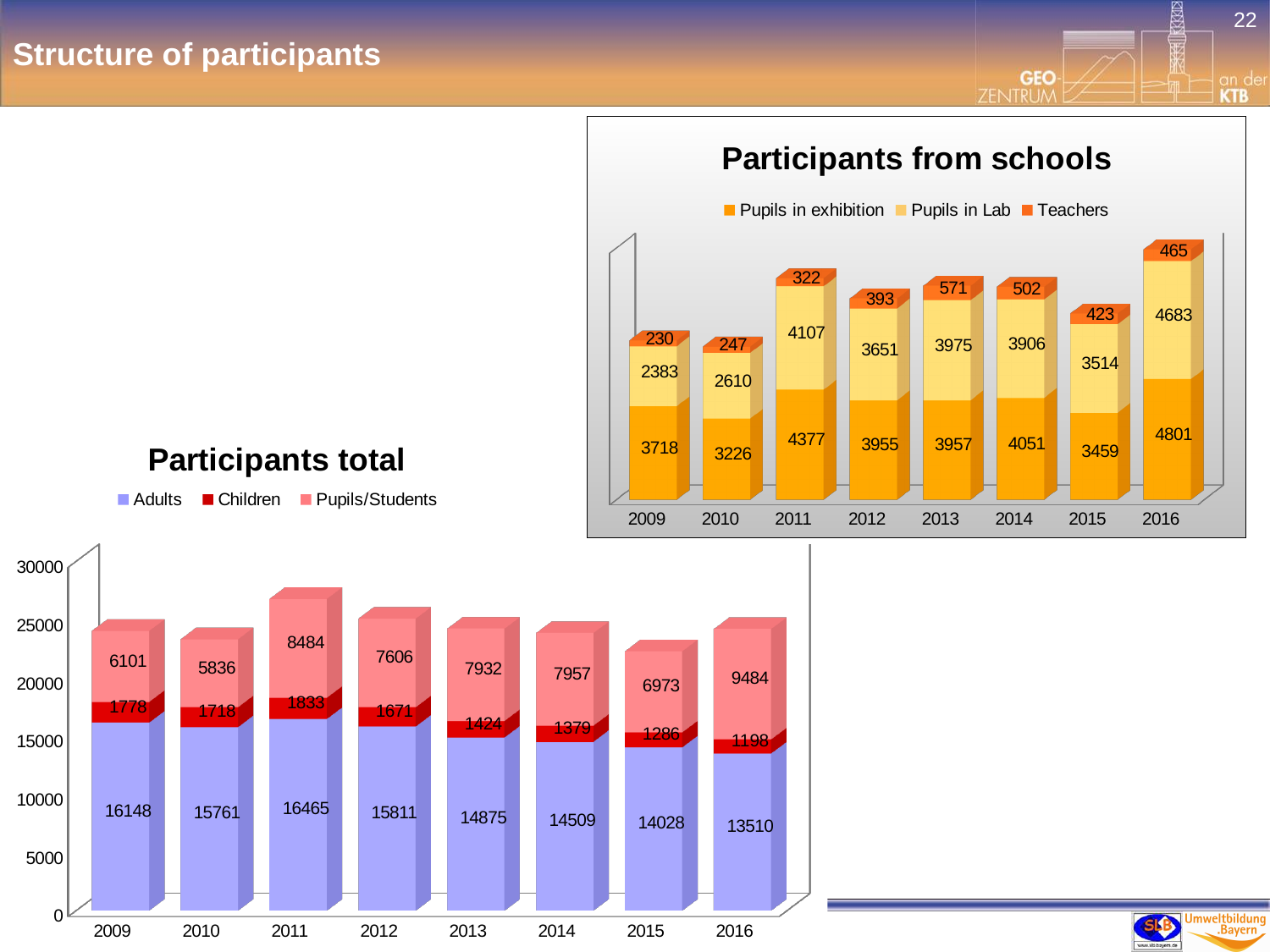
In the 'Participants from schools' chart, is the value for Pupils in exhibition larger in 2011 or in 2015? 2011 In the 'Participants total' chart, what is the total of the stacked bar for 2009? 24027 In the 'Participants total' chart, which year has the lowest value for Children? 2016 In the 'Participants from schools' chart, which year has the highest value for Pupils in Lab? 2016 How many series does the legend of the 'Participants from schools' chart list? 3 In the 'Participants total' chart, which year has the highest value for Adults? 2011 In the 'Participants from schools' chart, what is the total of the stacked bar for 2016? 9949 In the 'Participants total' chart, what is the difference between the Pupils/Students values for 2016 and 2009? 3383 In the 'Participants total' chart, what is the value for Pupils/Students in 2011? 8484 In the 'Participants from schools' chart, what is the value for Teachers in 2013? 571 In the 'Participants total' chart, do the Adults values rise or fall from 2011 to 2016? fall In the 'Participants total' chart, what is the value for Adults in 2016? 13510